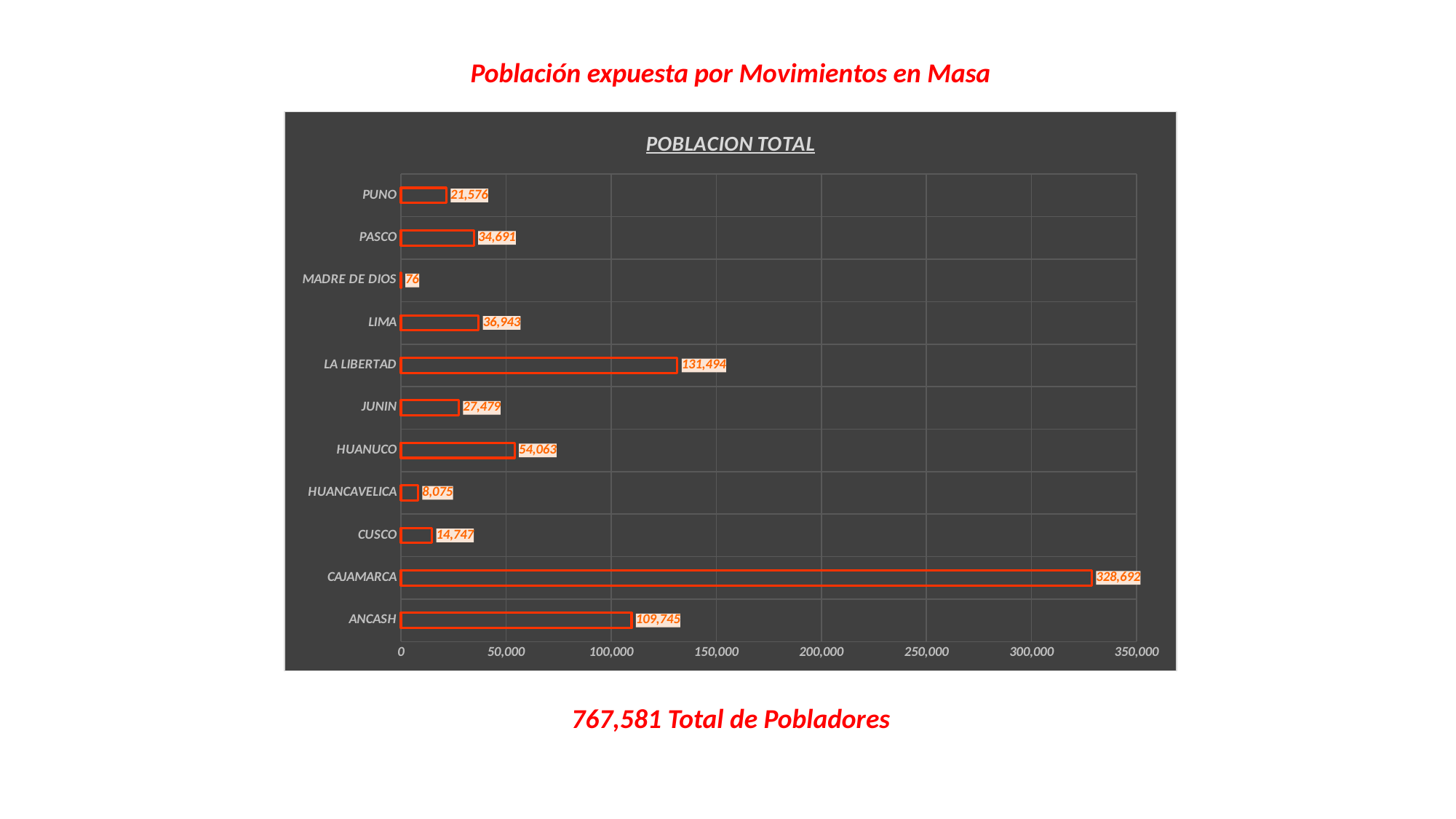
What is the difference between the values for HUANUCO and JUNIN? 26,584 Which category has the lowest value? MADRE DE DIOS What is the difference between the values for CAJAMARCA and ANCASH? 218,947 How many categories are shown in the chart? 11 What is the value for CAJAMARCA? 328,692 What kind of chart is shown? Bar chart What is the value for LA LIBERTAD? 131,494 Is the value for HUANUCO greater or less than 50,000? greater Which category has the highest value? CAJAMARCA Which is larger, the value for LIMA or the value for PASCO? LIMA What is the value for MADRE DE DIOS? 76 What is the title of the chart? POBLACION TOTAL